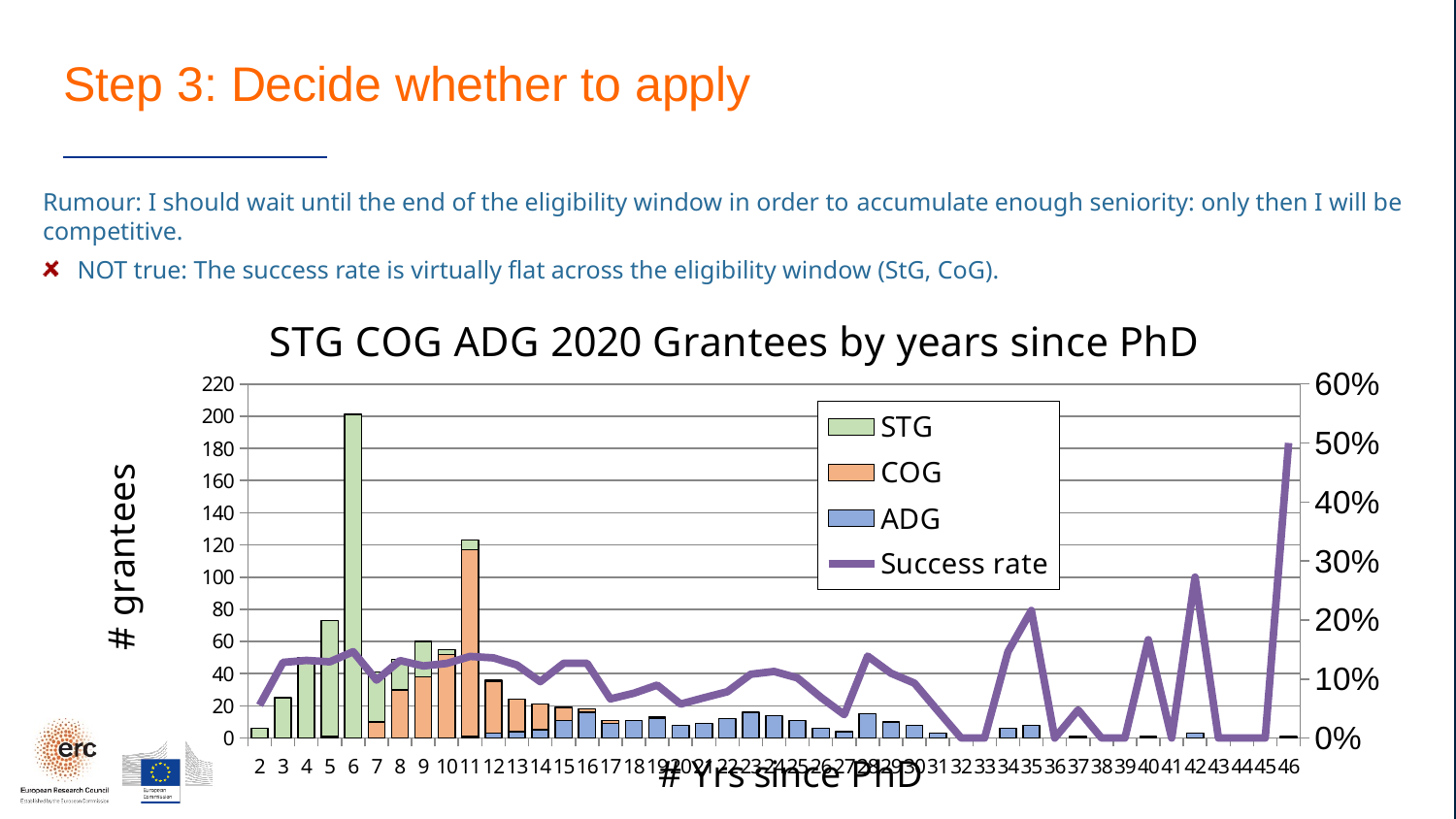
Is the total bar height for year 11 greater or less than 100? greater How many series does the legend list? 4 What is the label of the left vertical axis? # grantees Is the Success rate at year 46 greater or less than 40%? greater Which has the taller bar, year 6 or year 11? 6 Which has the taller bar, year 4 or year 5? 5 Is the total bar height for year 6 greater or less than 180? greater Which year since PhD has the tallest bar? 6 At which year since PhD does the Success rate line reach its highest point? 46 What kind of chart is shown on the slide? A bar chart with a line (combination chart) What is the title of the chart? STG COG ADG 2020 Grantees by years since PhD